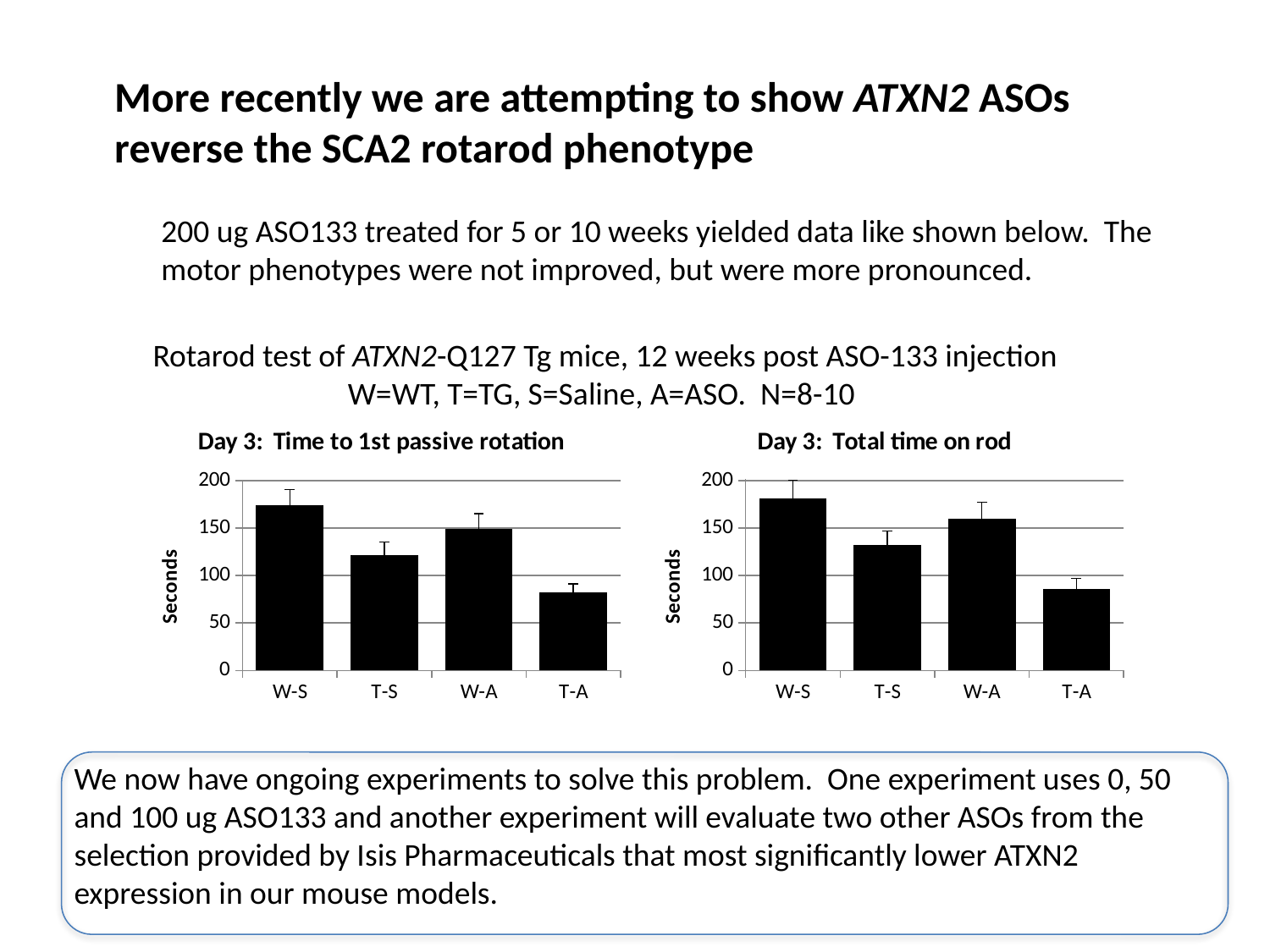
In the chart titled "Day 3: Time to 1st passive rotation", which category has the lowest bar? T-A In the chart titled "Day 3: Total time on rod", which is larger, the value for W-A or the value for T-S? W-A In the chart titled "Day 3: Time to 1st passive rotation", is the value for T-A greater or less than 100? less In the chart titled "Day 3: Total time on rod", which category has the lowest bar? T-A In the chart titled "Day 3: Time to 1st passive rotation", which category has the highest bar? W-S In the chart titled "Day 3: Time to 1st passive rotation", how many categories are plotted on the x axis? 4 In the chart titled "Day 3: Total time on rod", which category has the highest bar? W-S In the chart titled "Day 3: Total time on rod", is the value for W-S greater or less than 150? greater In the chart titled "Day 3: Total time on rod", what is the label on the y axis? Seconds In the chart titled "Day 3: Time to 1st passive rotation", which is larger, the value for T-S or the value for W-A? W-A What is the title of the chart on the right side of the slide? Day 3: Total time on rod In the chart titled "Day 3: Time to 1st passive rotation", what kind of chart is shown? bar chart